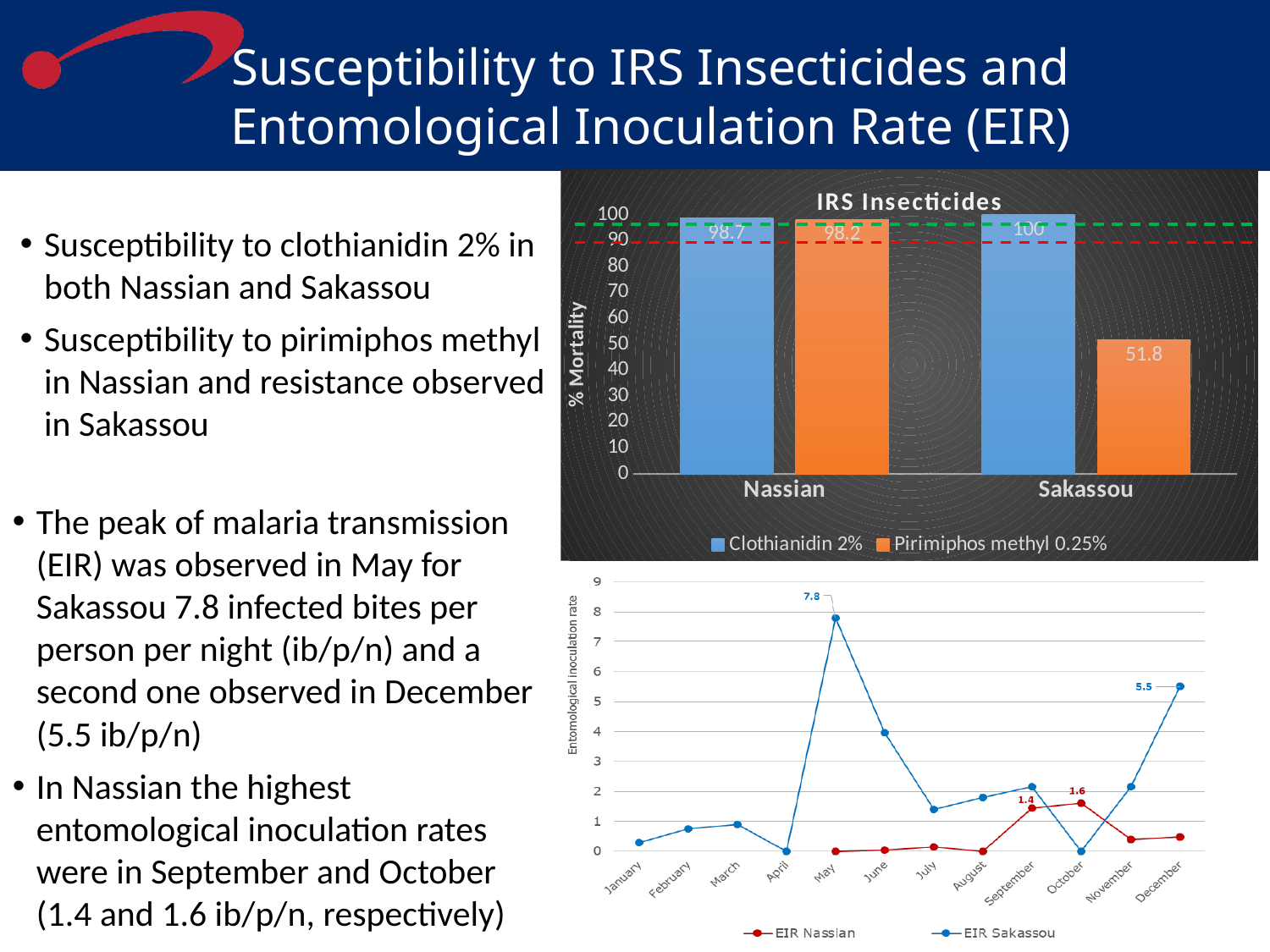
What kind of chart is the IRS Insecticides chart? Bar chart In the bottom EIR line chart, what is the EIR Nassian value in October? 1.6 In the IRS Insecticides chart, what is the % mortality for Clothianidin 2% in Nassian? 98.7 In the bottom EIR line chart, what is the EIR Sakassou value in May? 7.8 In the IRS Insecticides chart, what is the difference in % mortality between Clothianidin 2% and Pirimiphos methyl 0.25% in Sakassou? 48.2 In the IRS Insecticides chart, which bar has the lowest % mortality? Pirimiphos methyl 0.25% in Sakassou In the IRS Insecticides chart, what is the % mortality for Clothianidin 2% in Sakassou? 100 In the IRS Insecticides chart, what is the % mortality for Pirimiphos methyl 0.25% in Sakassou? 51.8 In the bottom EIR line chart, how many months are shown on the x axis? 12 In the IRS Insecticides chart, how many series does the legend list? 2 In the bottom EIR line chart, is the EIR Sakassou value in June greater or less than 3? greater In the bottom EIR line chart, what is the EIR Sakassou value in December? 5.5